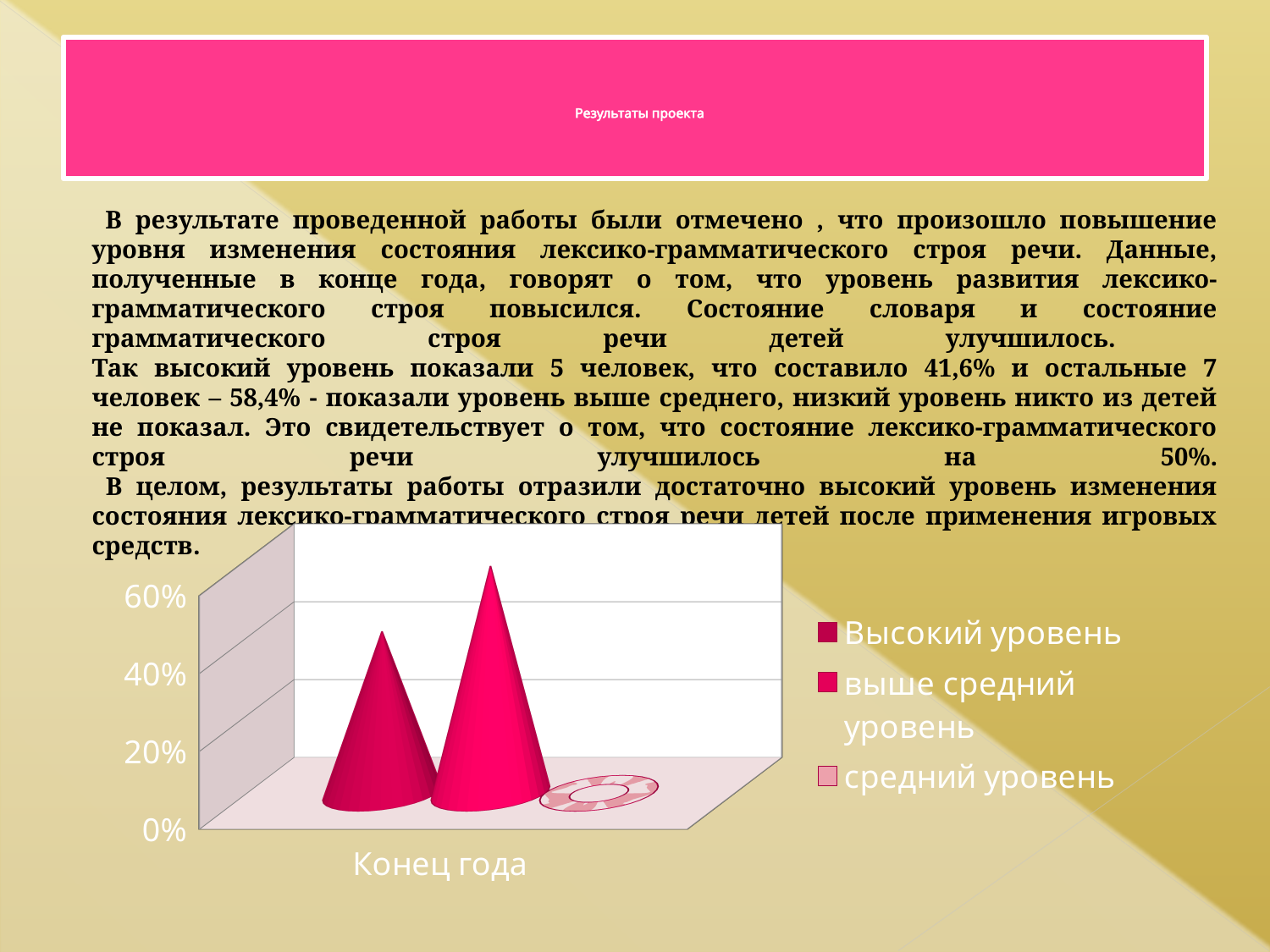
Which series has the lowest value in the chart? средний уровень Is the value for выше средний уровень greater or less than 40%? greater How many categories are shown on the x axis of the chart? 1 What kind of chart is shown on the slide? bar chart Is the value for средний уровень greater or less than 20%? less What is the category label on the x axis of the chart? Конец года Is the value for Высокий уровень greater or less than 60%? less How many series does the chart legend list? 3 Which series has the highest value in the chart? выше средний уровень Which is larger in the chart: the value for Высокий уровень or the value for выше средний уровень? выше средний уровень What is the highest tick value shown on the vertical axis of the chart? 60%